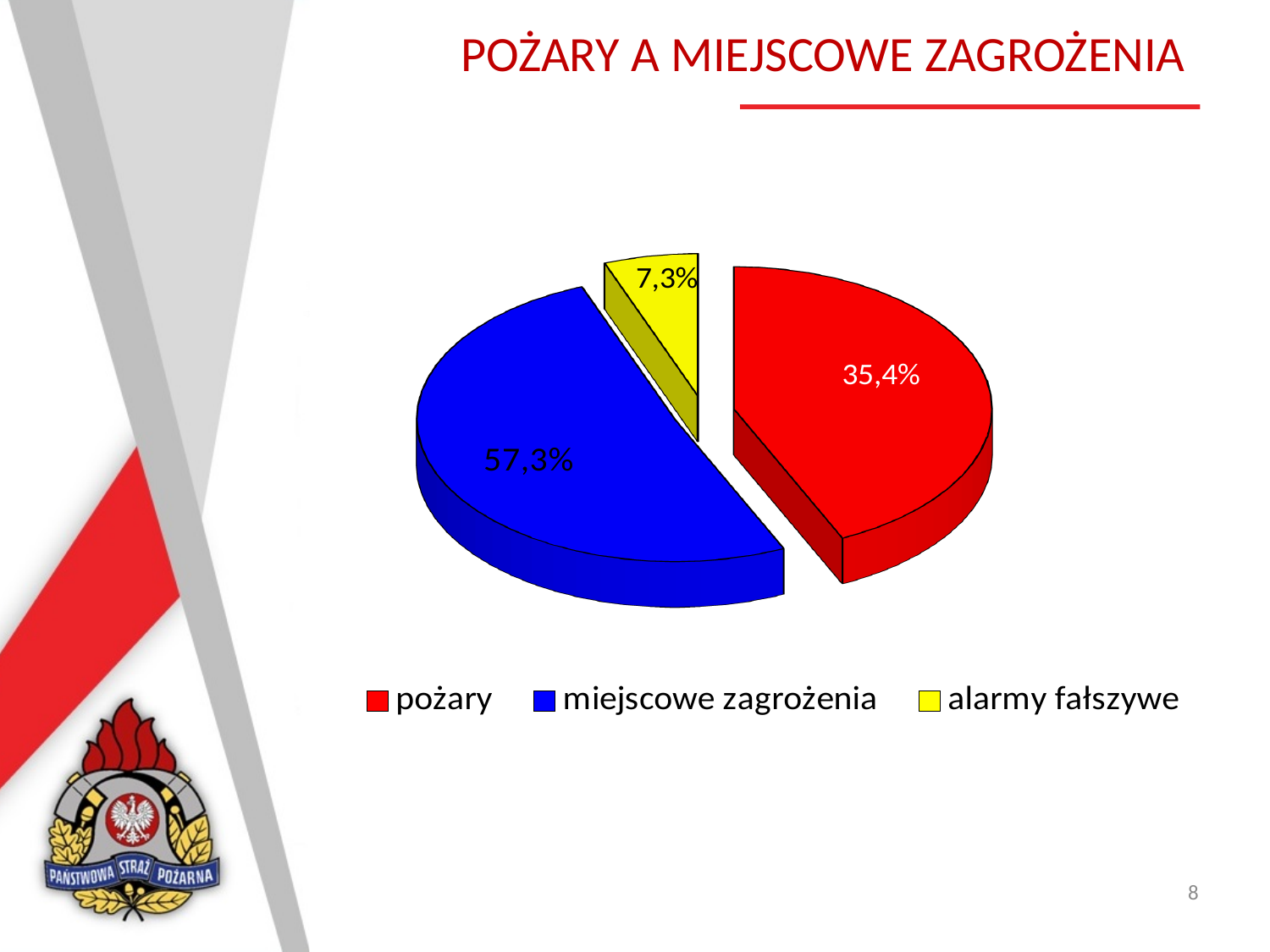
How many categories does the pie chart have? 3 What colour is the slice for "alarmy fałszywe"? yellow What share of the pie does "alarmy fałszywe" have? 7,3% What kind of chart is shown on the slide? pie chart What is the title of the chart on the slide? POŻARY A MIEJSCOWE ZAGROŻENIA What share of the pie does "miejscowe zagrożenia" have? 57,3% What is the difference in percentage points between "pożary" and "alarmy fałszywe"? 28,1 Which category has the largest slice of the pie? miejscowe zagrożenia Which category has the smallest slice of the pie? alarmy fałszywe What is the difference in percentage points between "miejscowe zagrożenia" and "pożary"? 21,9 What share of the pie does "pożary" have? 35,4% Which is larger, the share for "pożary" or the share for "miejscowe zagrożenia"? miejscowe zagrożenia